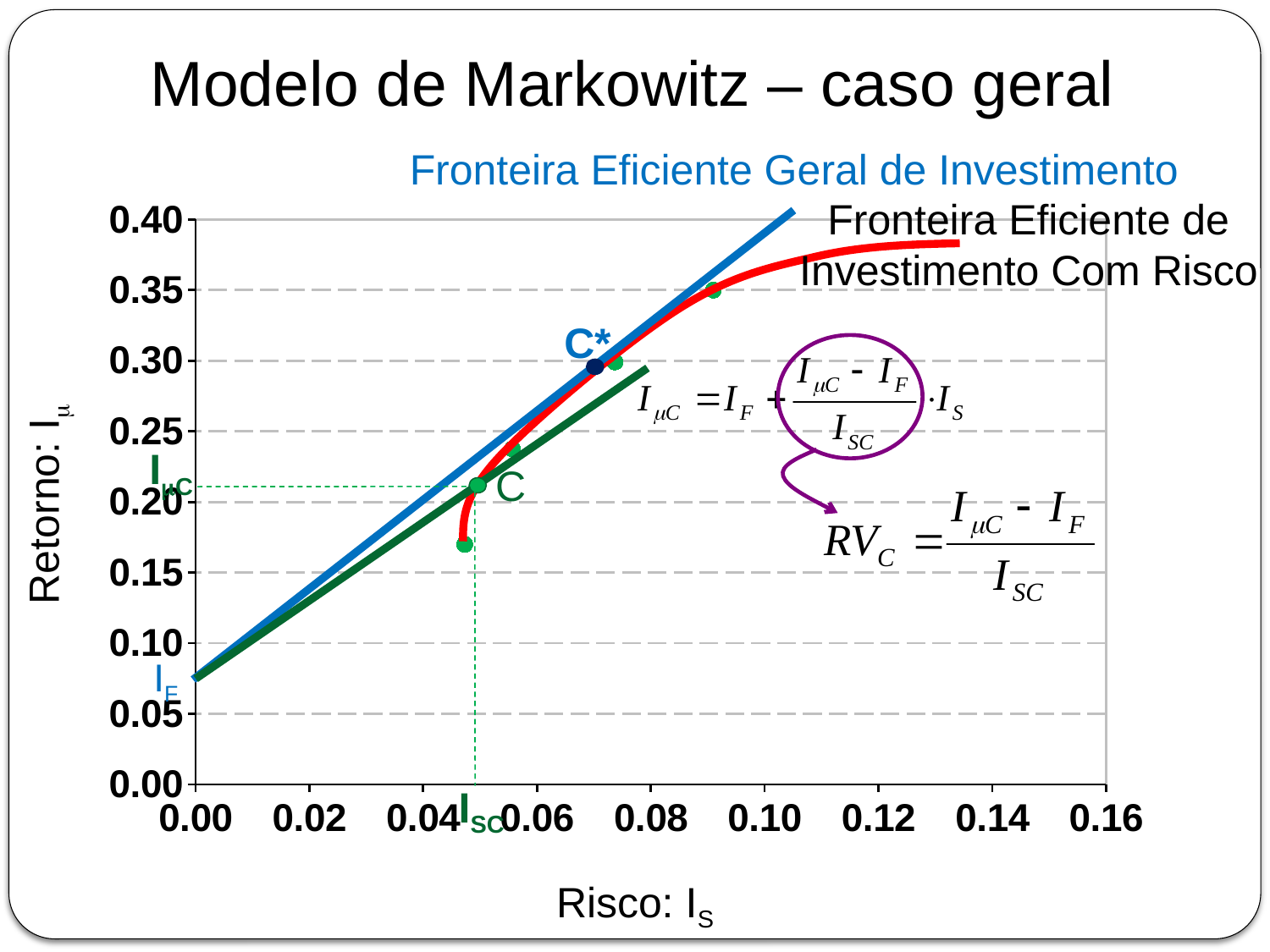
What is the label of the vertical axis of the chart? Retorno: I_μ Is the return where the blue line meets the vertical axis (I_F) greater or less than 0.10? less How many tick labels are shown on the horizontal axis? 9 Is the risk (horizontal value) at point C* greater or less than 0.06? greater Is the highest return reached by the red curve greater or less than 0.40? less Does the blue line rise or fall as risk increases along the x axis? rise What is the label of the horizontal axis of the chart? Risco: I_S Which point has the higher return, C or C*? C* What kind of chart is shown on the slide? line chart